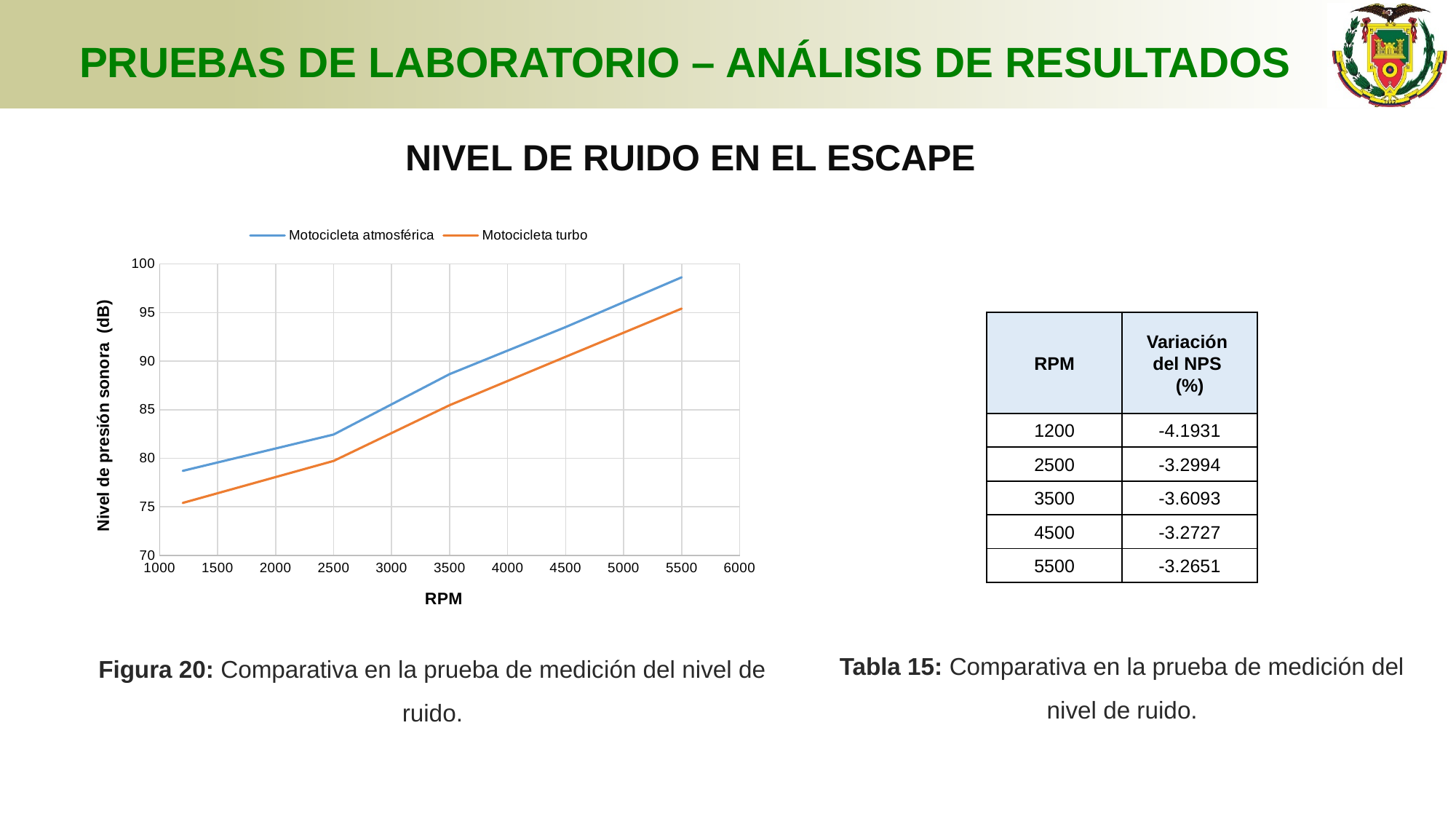
What are the two series named in the chart legend? Motocicleta atmosférica and Motocicleta turbo Is the value for Motocicleta atmosférica at 5500 RPM greater or less than 95? greater Is the value for Motocicleta turbo at 4500 RPM greater or less than 85? greater What is the label of the vertical axis of the chart? Nivel de presión sonora (dB) Do the values for Motocicleta atmosférica rise or fall as RPM increases? rise What kind of chart is shown in Figura 20? line chart Do the values for Motocicleta turbo rise or fall as RPM increases? rise Which series has the lower sound pressure level at 5500 RPM? Motocicleta turbo How many series does the legend of the chart list? 2 How many data points are plotted for each series in the chart? 5 Which series has the higher sound pressure level at 3500 RPM, Motocicleta atmosférica or Motocicleta turbo? Motocicleta atmosférica Is the value for Motocicleta turbo at 1200 RPM greater or less than 80? less